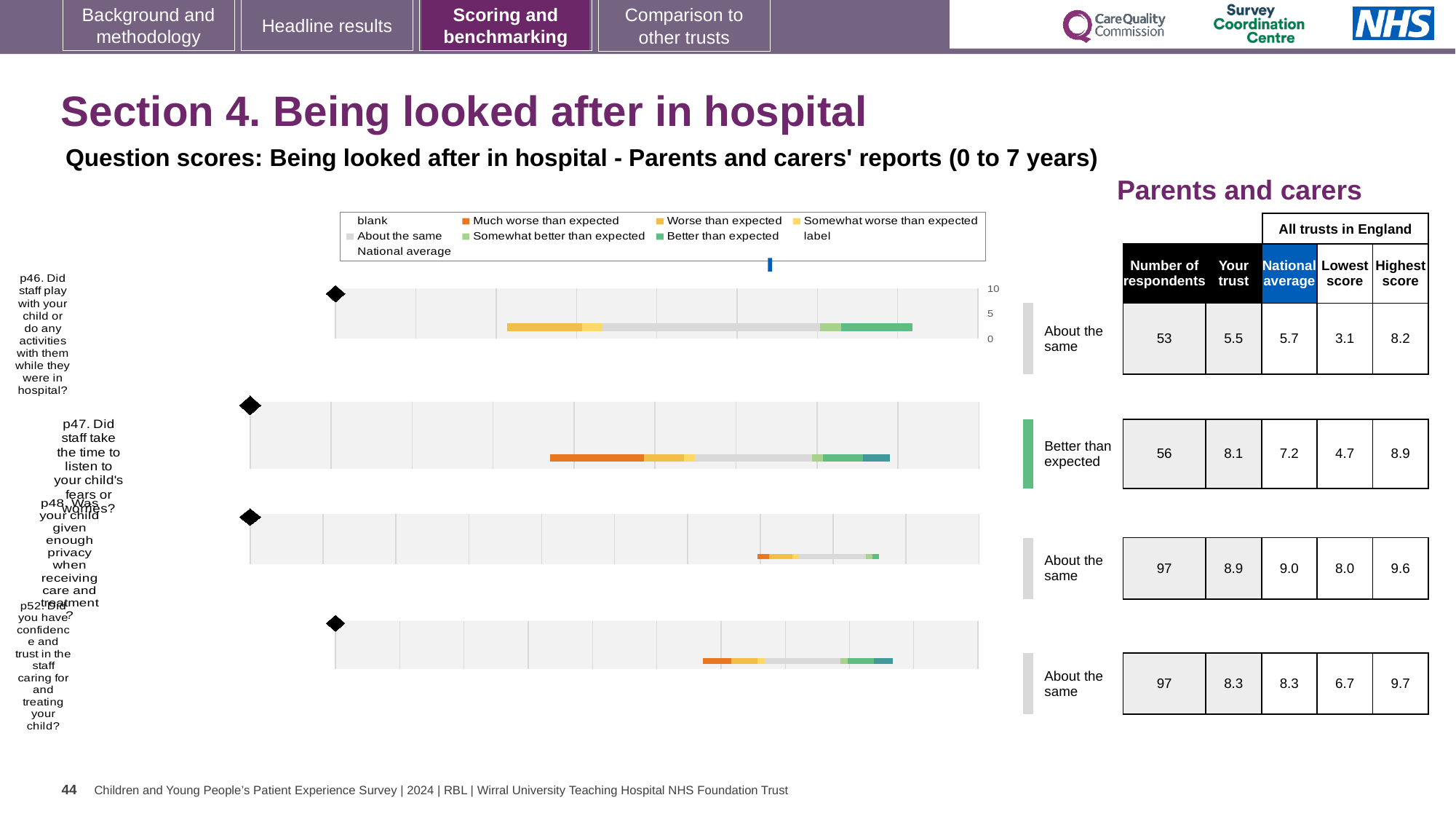
How many respondents answered p48 (Was your child given enough privacy)? 97 What is the lowest score among all trusts in England for p46? 3.1 For p46, which is larger: the 'Your trust' score or the national average? National average Which question has the lowest 'Your trust' score? p46 What is the 'Your trust' score for p47 (Did staff take the time to listen to your child's fears or worries)? 8.1 What is the highest score among all trusts in England for p52 (Did you have confidence and trust in the staff)? 9.7 Which question has the highest 'Your trust' score? p48 What kind of chart is used to show the question scores on this slide? bar chart What benchmark category is shown for p47? Better than expected For p47, how much higher is the 'Your trust' score than the national average? 0.9 What is the national average score for p46 (Did staff play with your child or do any activities with them)? 5.7 How many questions (p46, p47, p48, p52) have a score bar on this slide? 4